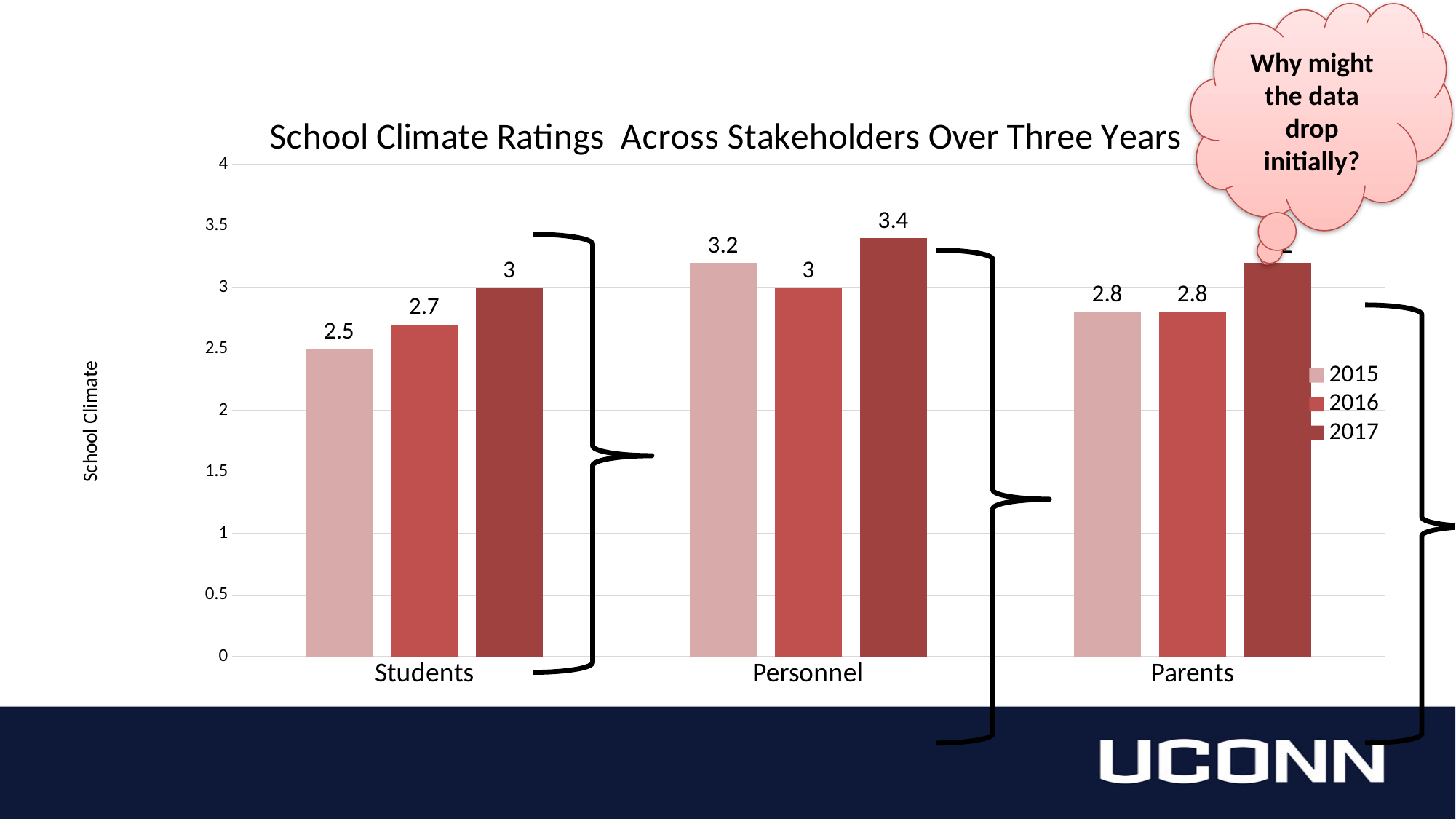
Which stakeholder group had the highest rating in 2015? Personnel What is the 2017 school climate rating for Personnel? 3.4 What is the 2016 school climate rating for Parents? 2.8 What is the title of the chart? School Climate Ratings Across Stakeholders Over Three Years Is the 2017 value for Parents greater or less than 3? greater Which stakeholder group had the lowest rating in 2017? Students What is the difference between the 2017 and 2015 ratings for Students? 0.5 What kind of chart is shown on the slide? bar chart What is the 2015 school climate rating for Students? 2.5 Which is larger for Personnel: the 2015 rating or the 2016 rating? 2015 How many stakeholder categories are shown on the x axis? 3 How many series does the legend list? 3